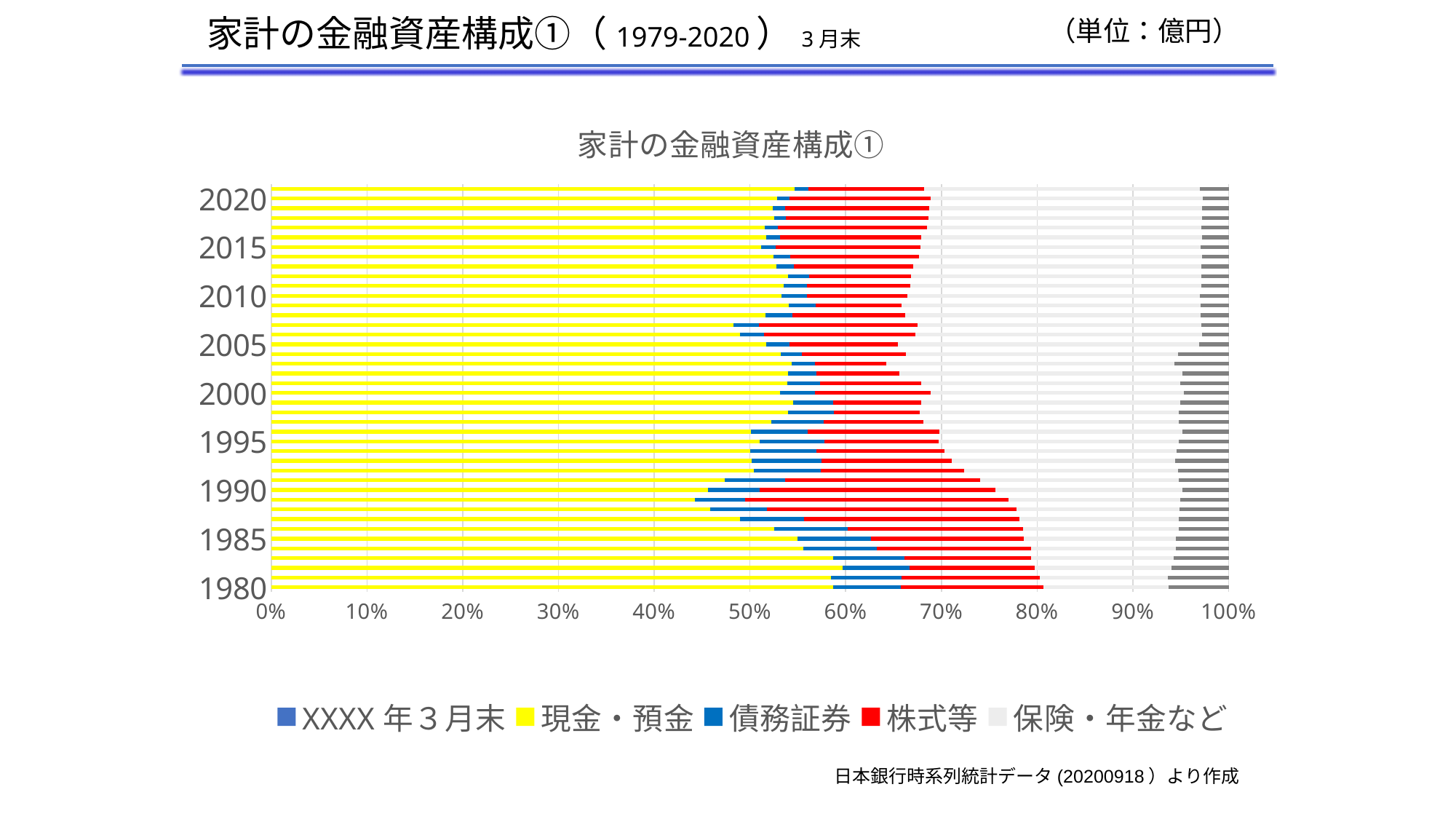
Which year has the larger share of 現金・預金, 1980 or 1990? 1980 How many series does the legend list? 5 Is the share of 現金・預金 in 2020 greater or less than 60%? less What is the title of the chart? 家計の金融資産構成① Which year has the larger share of 株式等, 1985 or 2020? 1985 Which year has the larger share of 保険・年金など, 1980 or 2020? 2020 What is the highest value shown on the horizontal axis? 100% Is the share of 現金・預金 in 1990 greater or less than 50%? less Is the share of 現金・預金 in 1980 greater or less than 50%? greater Which colour represents 株式等 in the chart? red What kind of chart is shown on the slide? stacked bar chart